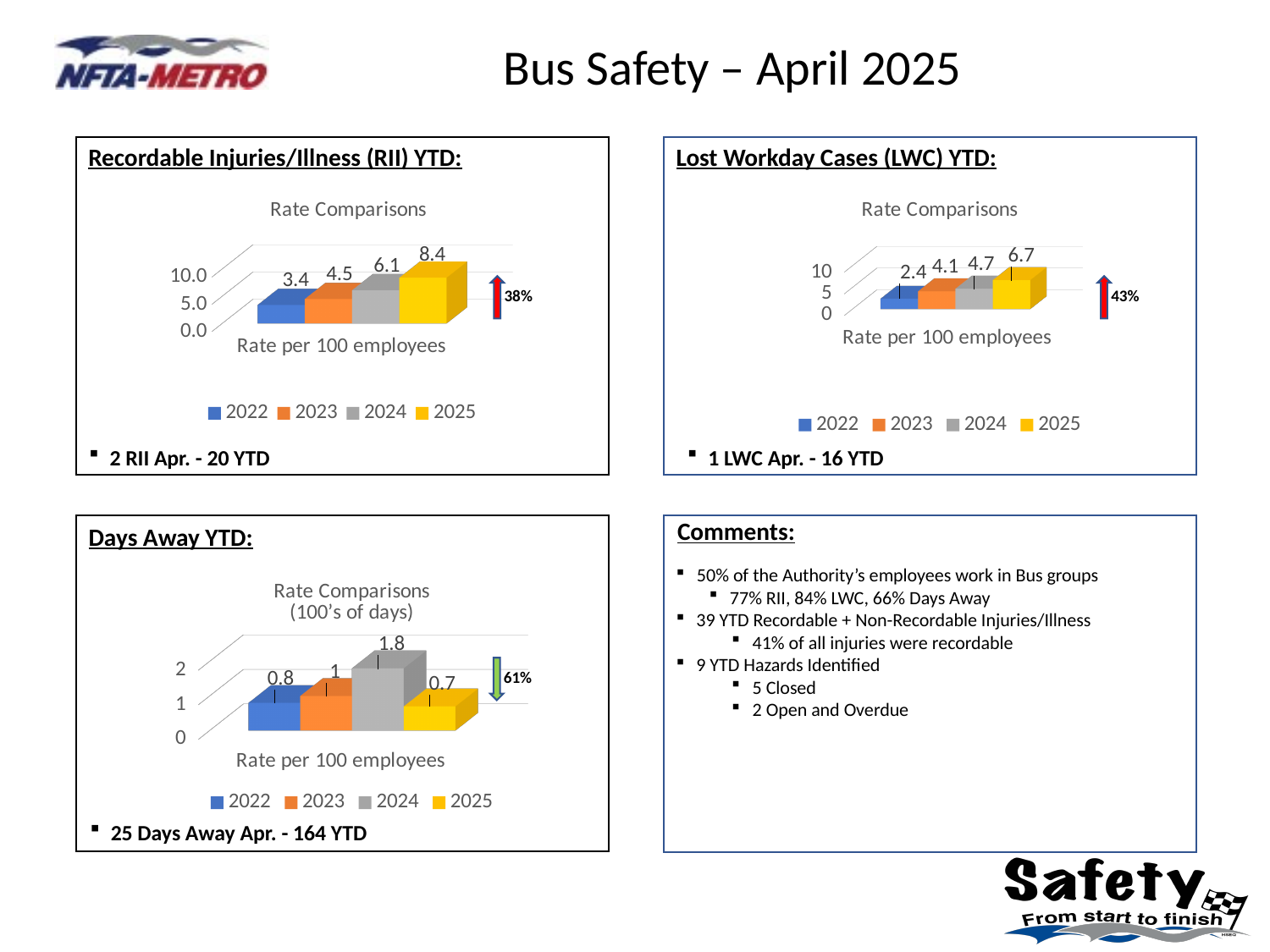
In the Days Away YTD chart, which year has the lowest value? 2025 In the Lost Workday Cases (LWC) YTD chart, which year has the highest rate? 2025 In the Lost Workday Cases (LWC) YTD chart, what is the rate per 100 employees for 2023? 4.1 In the Recordable Injuries/Illness (RII) YTD chart, which year has the lowest rate? 2022 In the Days Away YTD chart, what is the value for 2024? 1.8 How many series does the legend of the Days Away YTD chart list? 4 In the Lost Workday Cases (LWC) YTD chart, what is the difference between the 2025 and 2022 rates? 4.3 In the Recordable Injuries/Illness (RII) YTD chart, what is the difference between the 2025 and 2024 rates? 2.3 In the Recordable Injuries/Illness (RII) YTD chart, what is the rate per 100 employees for 2025? 8.4 In the Days Away YTD chart, which is larger, the value for 2023 or the value for 2025? 2023 What kind of chart is the Lost Workday Cases (LWC) YTD chart? bar chart In the Recordable Injuries/Illness (RII) YTD chart, do the values rise or fall from 2022 to 2025? rise